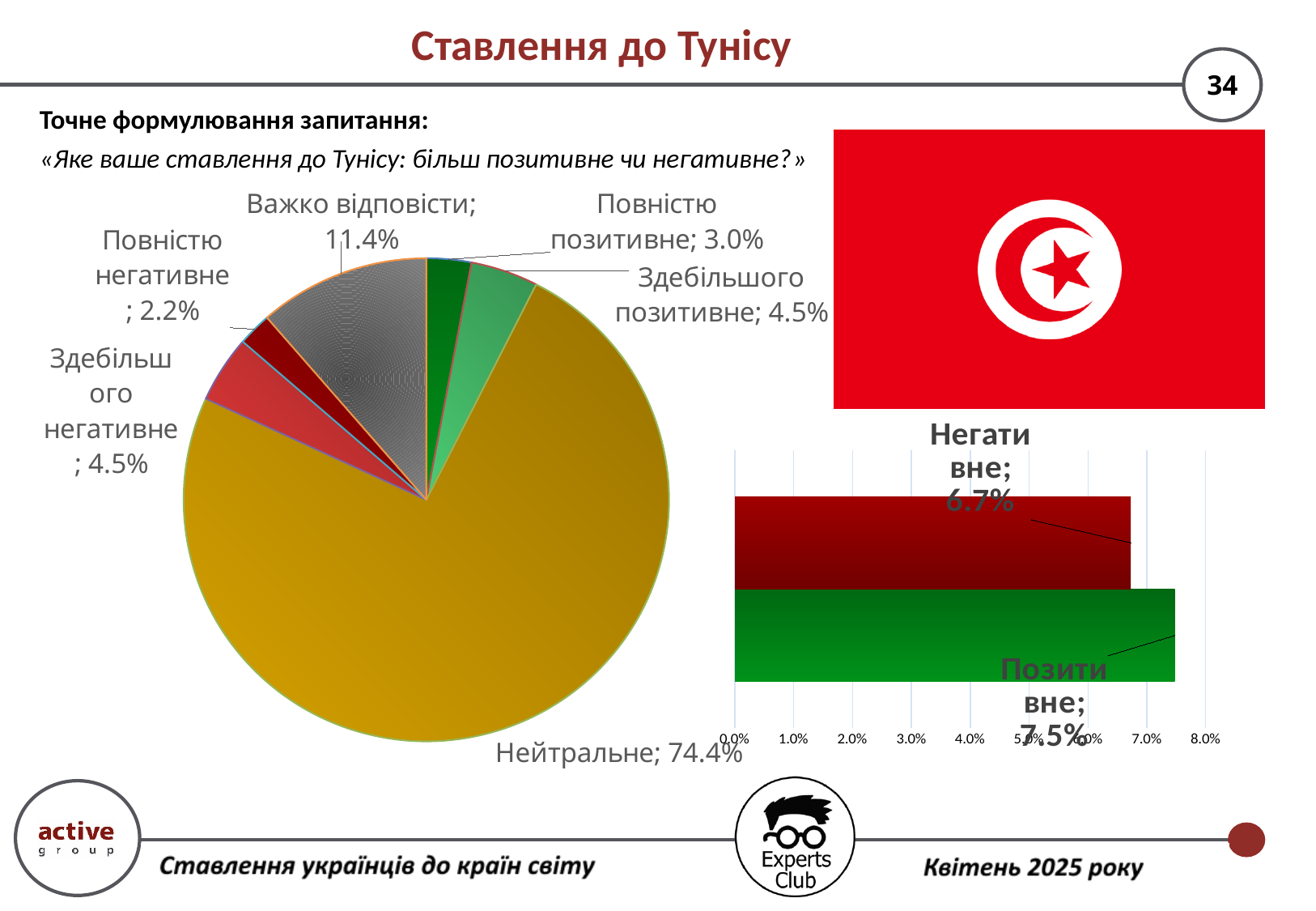
In the pie chart, what share is labelled for "Нейтральне"? 74.4% In the pie chart, which category has the smallest slice? Повністю негативне In the pie chart, what share is labelled for "Важко відповісти"? 11.4% In the pie chart, what is the difference between "Важко відповісти" and "Здебільшого позитивне"? 6.9% In the bar chart on the right, what is the value for "Позитивне"? 7.5% What type of chart is shown on the right side of the slide below the flag? Bar chart In the pie chart, how many slices (categories) are there? 6 In the pie chart, what share is labelled for "Повністю негативне"? 2.2% In the bar chart on the right, what is the value for "Негативне"? 6.7% In the pie chart, which category has the largest slice? Нейтральне In the pie chart, which is larger: "Повністю позитивне" or "Здебільшого позитивне"? Здебільшого позитивне In the bar chart on the right, what is the difference between "Позитивне" and "Негативне"? 0.8%